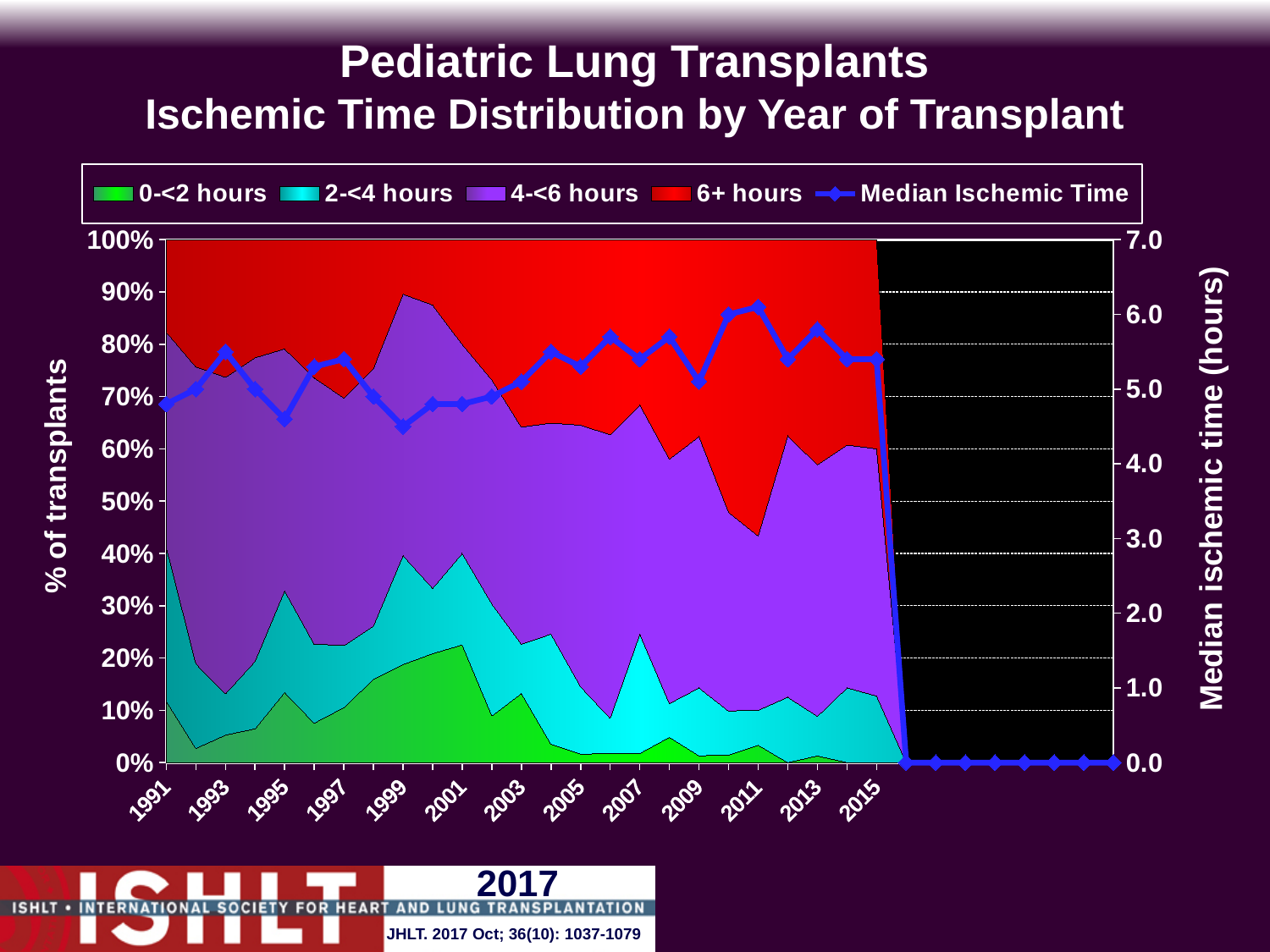
Is the Median Ischemic Time in 1999 greater or less than 5.0 hours? less What is the title of the chart? Pediatric Lung Transplants Ischemic Time Distribution by Year of Transplant Is the share of transplants with 2-<4 hours ischemic time in 2001 greater or less than 10%? greater How many series does the legend list? 5 Which year has the larger Median Ischemic Time, 1999 or 2007? 2007 Is the Median Ischemic Time in 2012 greater or less than 5.0 hours? greater Which year has the larger Median Ischemic Time, 1991 or 2011? 2011 Does the Median Ischemic Time generally rise or fall from 1991 to 2011? rise How many year labels are shown along the x axis? 13 What is the label of the right-hand vertical axis? Median ischemic time (hours) What kind of chart is shown on the slide? Stacked area chart with a line overlay